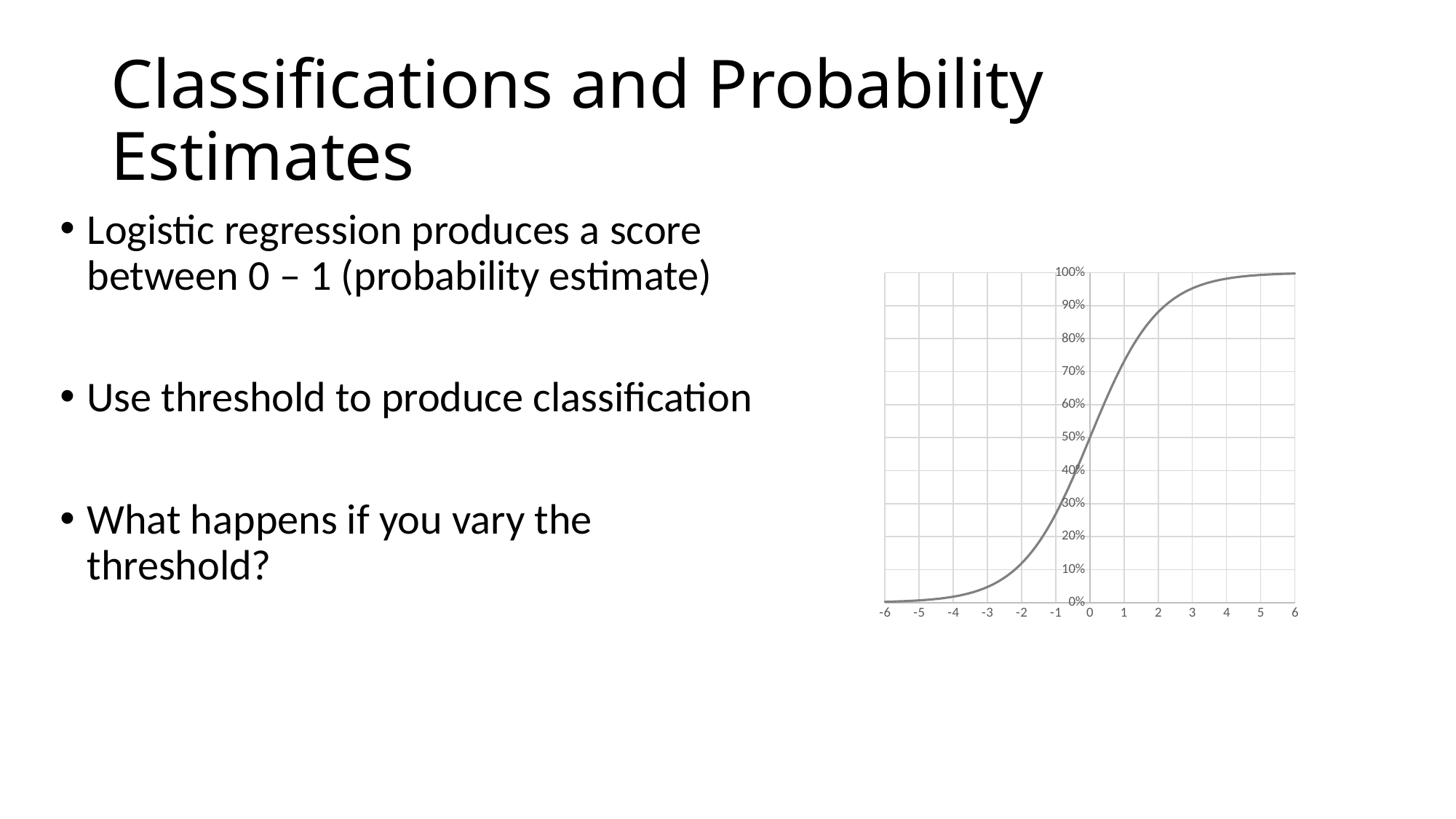
Is the value of the curve at x = 1 greater or less than 60%? greater At which x value does the curve reach its highest point? 6 Is the value of the curve at x = 2 greater or less than 80%? greater Is the value of the curve at x = 3 greater or less than 90%? greater Do the values on the chart rise or fall as x increases from -6 to 6? rise Which is larger, the value of the curve at x = 2 or at x = -2? x = 2 What is the range of the x axis on the chart? -6 to 6 What kind of chart is shown on the slide? line chart What value does the curve reach at x = 0? 50%